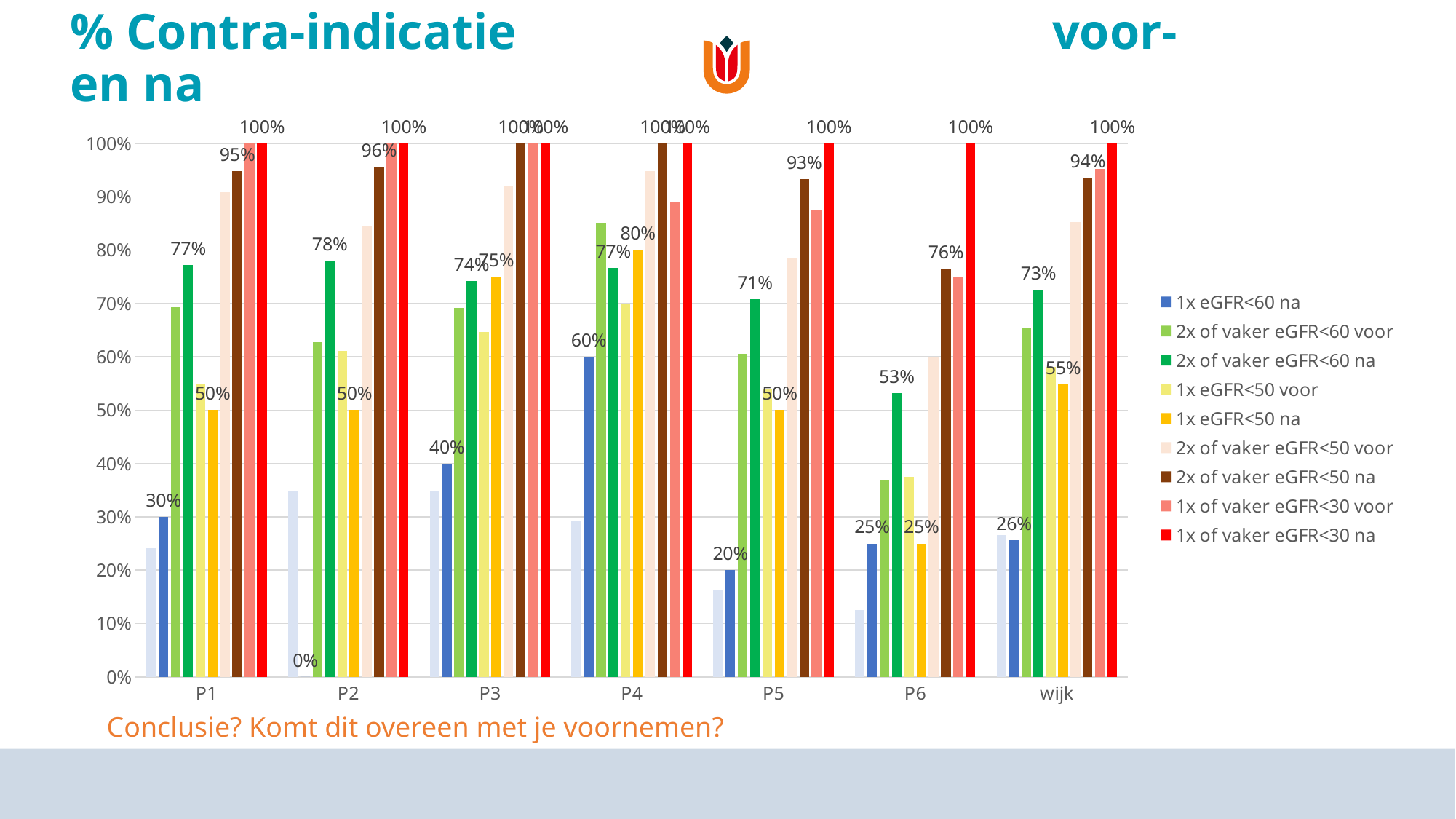
How many series does the chart's legend list? 9 What kind of chart is shown on the slide? bar chart What is the difference between the '2x of vaker eGFR<60 na' values for P2 and P6? 25 percentage points What is the value of '1x eGFR<50 na' for wijk? 55% What is the value of '1x eGFR<60 na' for P4? 60% How many categories are shown on the x axis of the chart? 7 What is the value of '2x of vaker eGFR<50 na' for P5? 93% Is the value of '2x of vaker eGFR<50 voor' for P1 greater or less than 80%? greater Which has the larger '1x eGFR<50 na' value, P4 or P6? P4 Which category has the highest value for '1x eGFR<60 na'? P4 Which category has the lowest value for '1x eGFR<60 na'? P2 What is the value of '2x of vaker eGFR<60 na' for P6? 53%